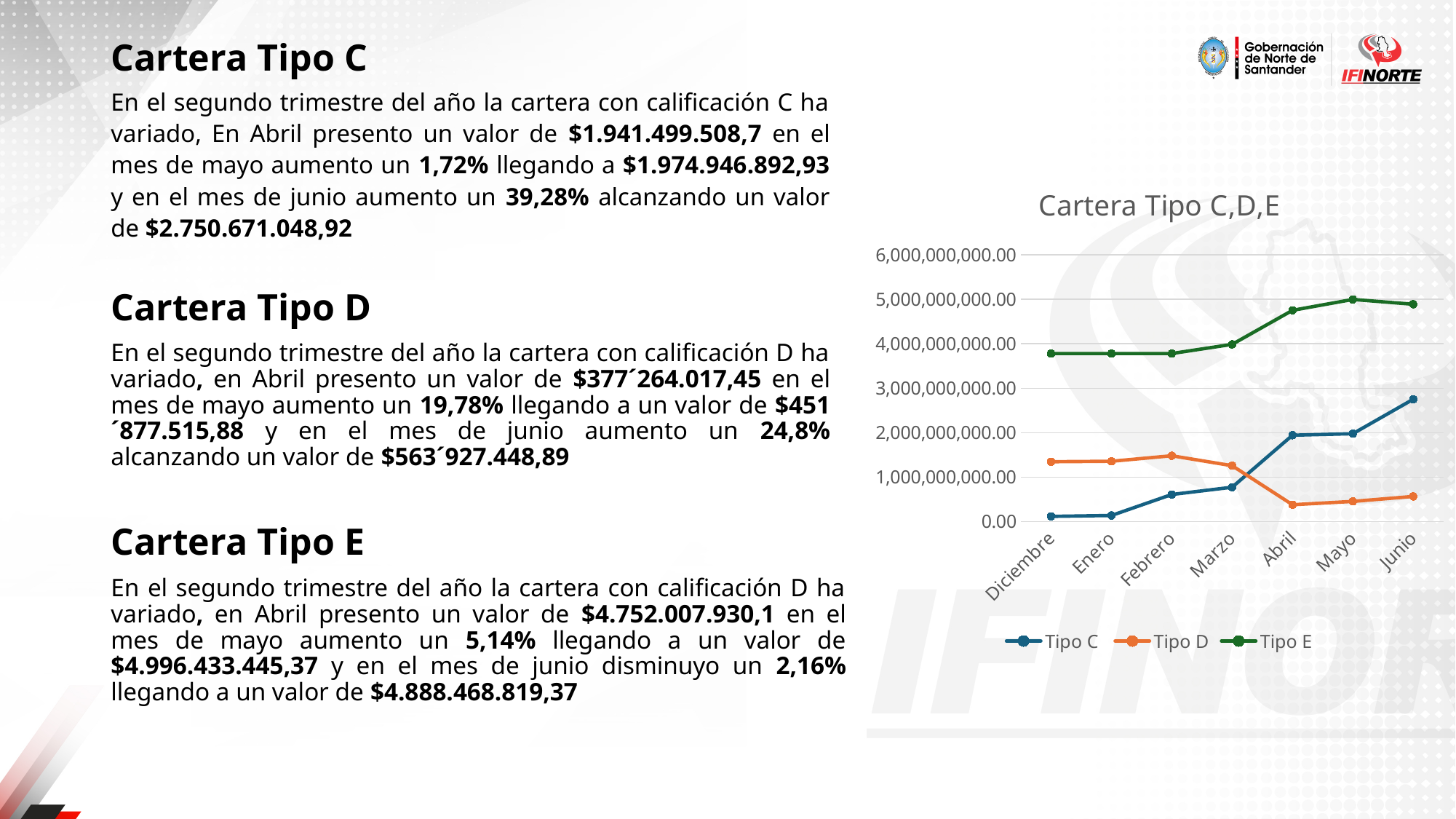
Which is larger in Marzo, Tipo C or Tipo D? Tipo D In which month does Tipo C reach its highest value? Junio What is the title of the chart? Cartera Tipo C,D,E What kind of chart is shown on the slide? Line chart How many series does the chart legend list? 3 Is the value for Tipo D in Abril greater or less than 1,000,000,000.00? less Does the Tipo C line rise or fall from Diciembre to Junio? Rise Is the value for Tipo C in Junio greater or less than 2,000,000,000.00? greater In which month does Tipo D reach its lowest value? Abril In which month does Tipo E reach its highest value? Mayo Which series has the highest value in Junio? Tipo E How many months are shown on the x axis of the chart? 7